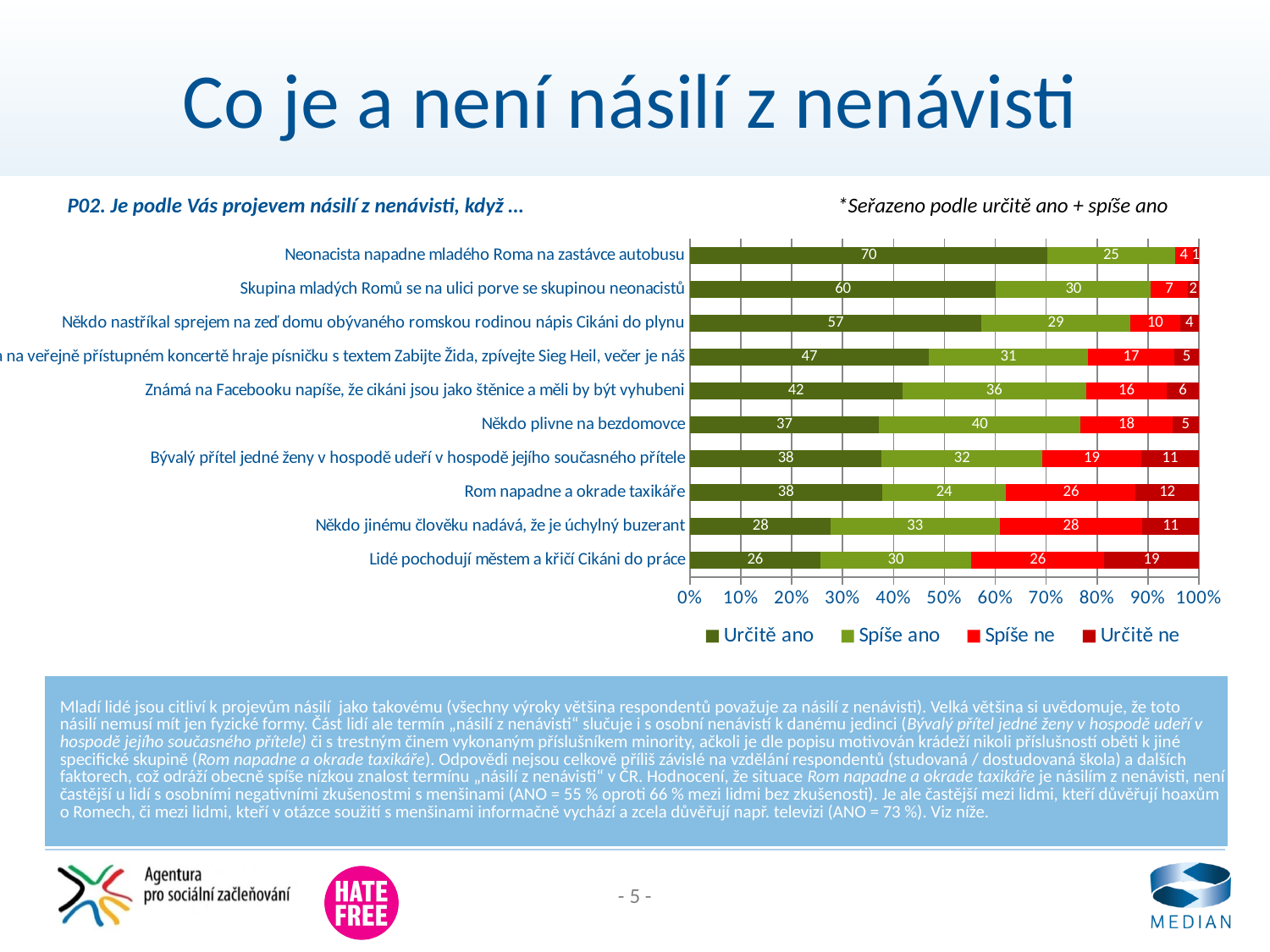
How many statements (categories) are shown in the chart? 10 How many series does the legend list? 4 What kind of chart is shown on the slide? Stacked bar chart Which statement has the lowest 'Určitě ano' value? Lidé pochodují městem a křičí Cikáni do práce What is the 'Spíše ano' value for 'Někdo plivne na bezdomovce'? 40 What is the 'Spíše ne' value for 'Rom napadne a okrade taxikáře'? 26 Which statement has the highest 'Určitě ano' value? Neonacista napadne mladého Roma na zastávce autobusu Which has a larger 'Spíše ne' value: 'Někdo plivne na bezdomovce' or 'Rom napadne a okrade taxikáře'? Rom napadne a okrade taxikáře What is the combined 'Určitě ano' and 'Spíše ano' value for 'Neonacista napadne mladého Roma na zastávce autobusu'? 95 What is the 'Určitě ne' value for 'Lidé pochodují městem a křičí Cikáni do práce'? 19 What is the difference between the 'Určitě ano' values for 'Skupina mladých Romů se na ulici porve se skupinou neonacistů' and 'Někdo jinému člověku nadává, že je úchylný buzerant'? 32 What is the 'Určitě ano' value for 'Neonacista napadne mladého Roma na zastávce autobusu'? 70